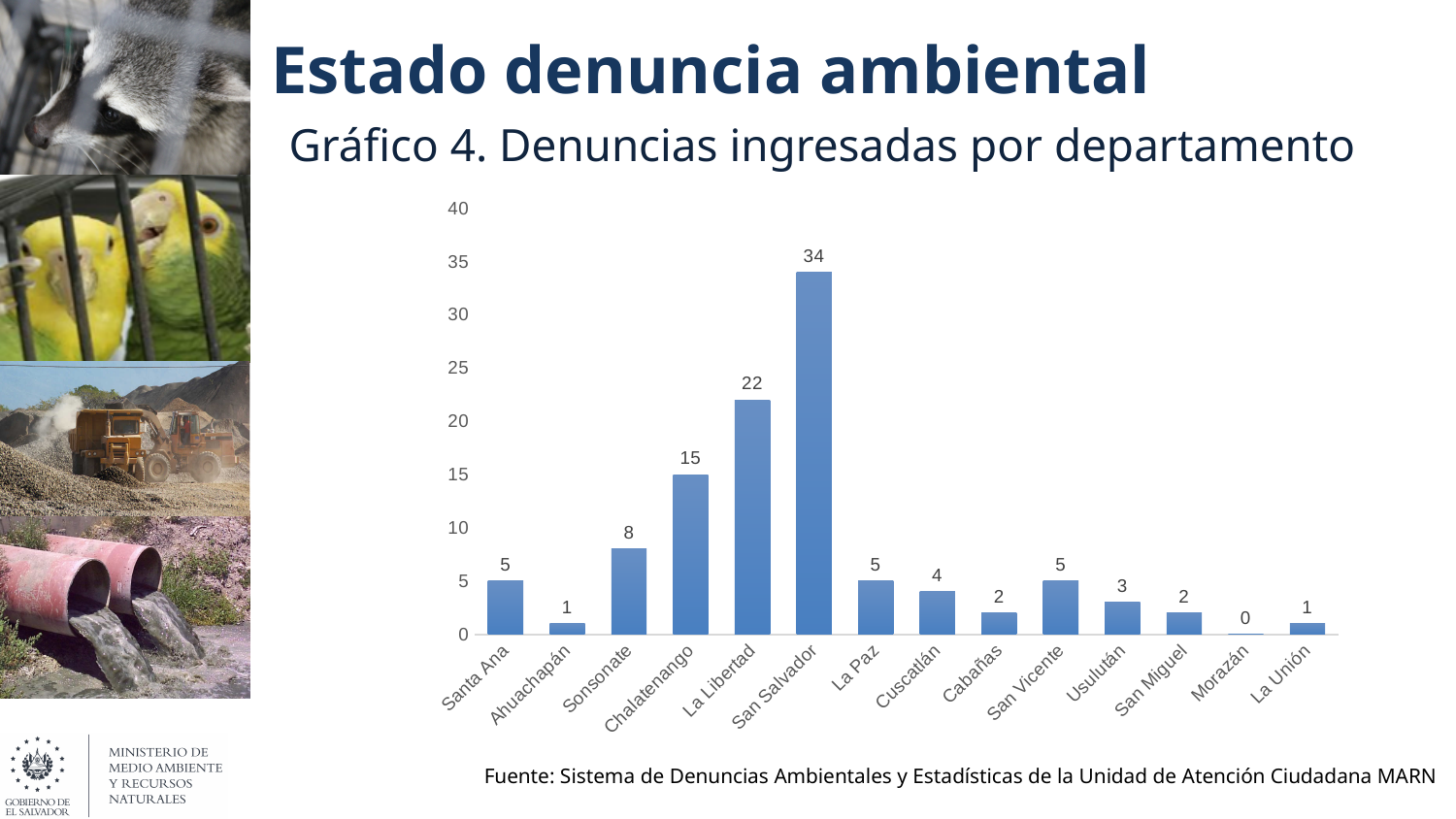
What is the value for San Salvador? 34 Which department has the lowest number of denuncias? Morazán What is the value for Usulután? 3 What is the value for Morazán? 0 Is the value for La Libertad greater or less than 20? greater What kind of chart is shown? Bar chart What is the value for Chalatenango? 15 How many departments are shown on the x axis? 14 What is the difference between the values for San Salvador and La Libertad? 12 Which department has the highest number of denuncias? San Salvador What is the title of the chart? Gráfico 4. Denuncias ingresadas por departamento Which is larger, the value for Sonsonate or the value for Cuscatlán? Sonsonate